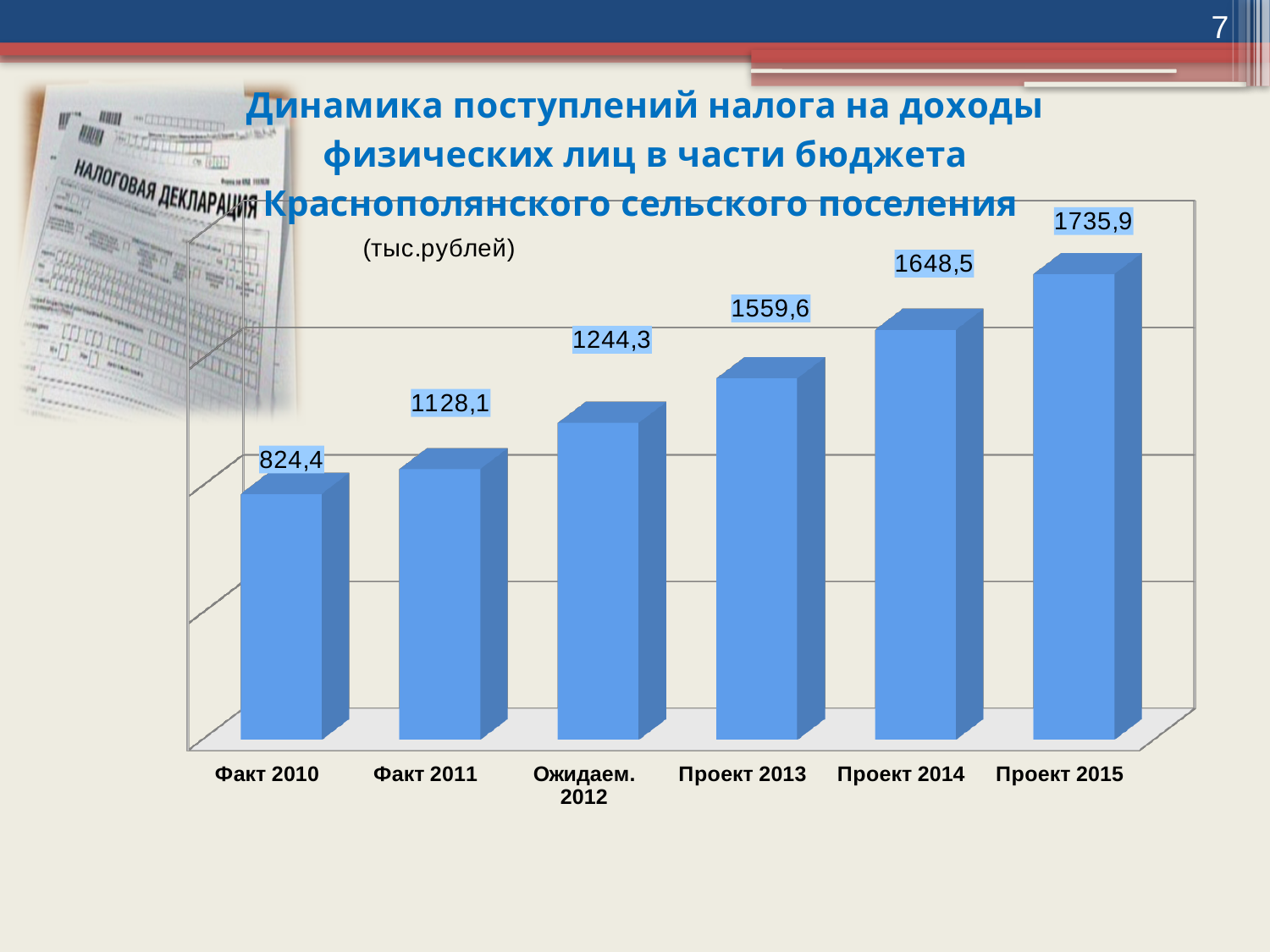
Which category has the highest value? Проект 2015 What is the value for Факт 2010? 824,4 What kind of chart is shown on the slide? bar chart What is the difference between the values for Факт 2011 and Факт 2010? 303,7 What is the value for Проект 2014? 1648,5 Which is larger, the value for Проект 2013 or the value for Ожидаем. 2012? Проект 2013 How many categories are shown on the chart? 6 Do the values rise or fall from Факт 2010 to Проект 2015? rise What is the value for Ожидаем. 2012? 1244,3 Which category has the lowest value? Факт 2010 What is the difference between the values for Проект 2015 and Факт 2010? 911,5 In what units are the chart values given? тыс.рублей